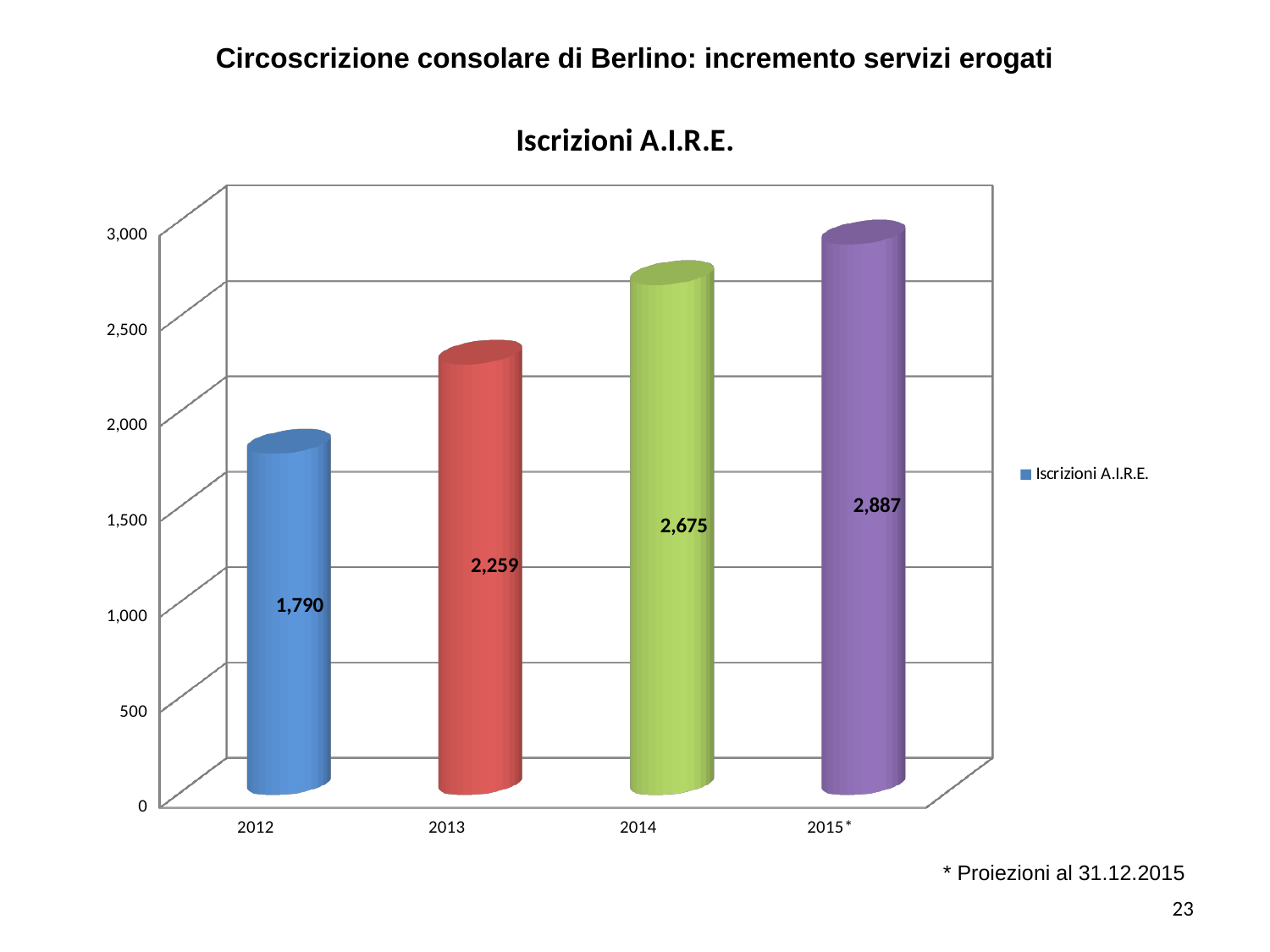
Which is larger, the value for 2013 or the value for 2014? 2014 What is the value for 2014? 2,675 How many years are shown on the x axis? 4 What kind of chart is this? bar chart Which year has the highest value? 2015* What is the value for 2015*? 2,887 What is the difference between the values for 2014 and 2013? 416 What is the difference between the values for 2015* and 2012? 1,097 Which year has the lowest value? 2012 What is the value for 2013? 2,259 Do the values rise or fall from 2012 to 2015*? rise What is the value for 2012? 1,790